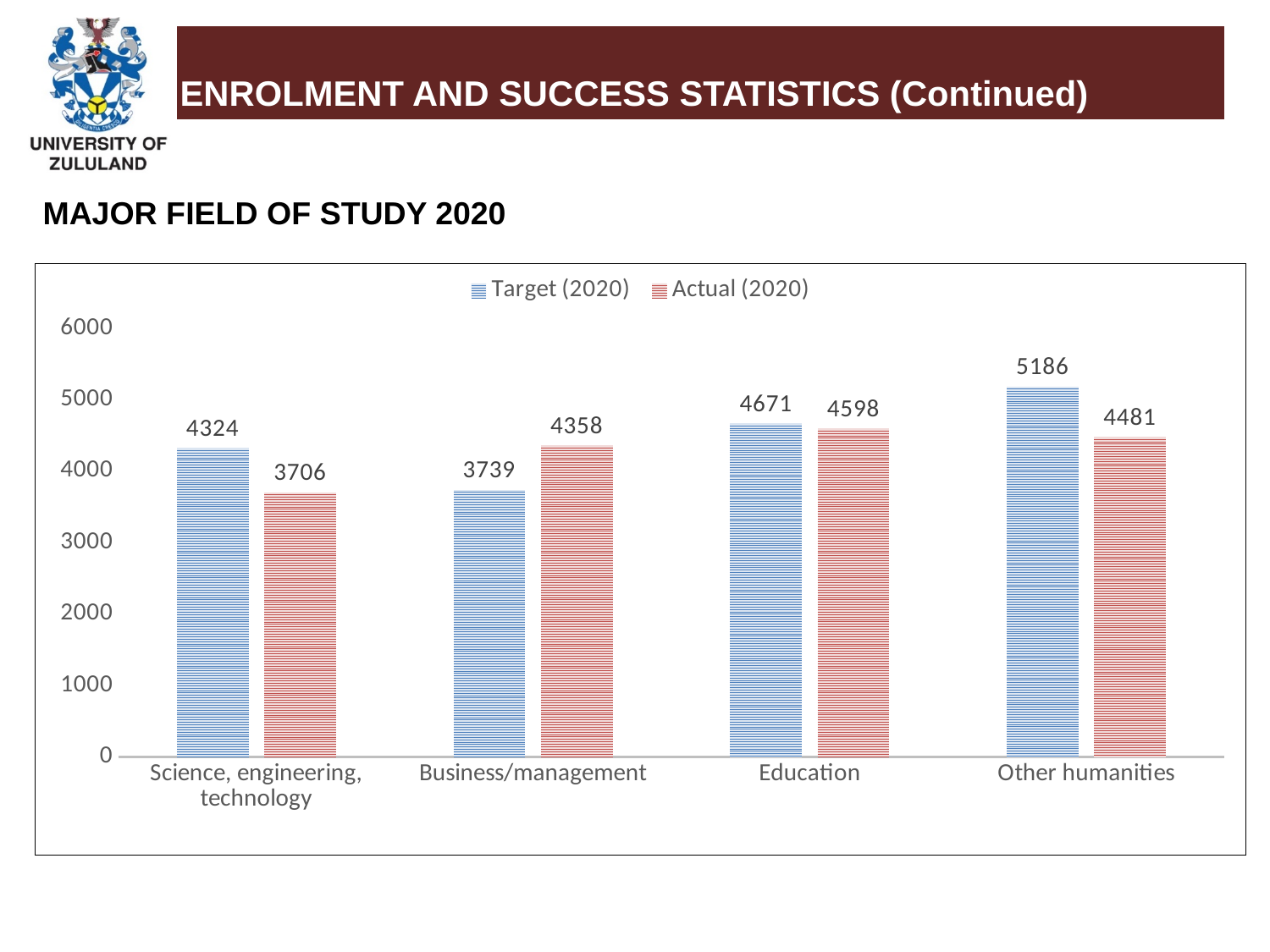
Which field has the highest Target (2020) value? Other humanities Is the Target (2020) value for Business/management greater or less than 4000? less Which field has the lowest Actual (2020) value? Science, engineering, technology Which colour represents the Actual (2020) series? red How many series does the legend list? 2 What is the Actual (2020) value for Science, engineering, technology? 3706 What is the difference between the Target (2020) and Actual (2020) values for Other humanities? 705 What is the Target (2020) value for Education? 4671 What kind of chart is shown on the slide? bar chart Which is larger for Business/management, the Target (2020) value or the Actual (2020) value? Actual (2020) How many fields of study are shown on the x axis? 4 What is the Actual (2020) value for Business/management? 4358